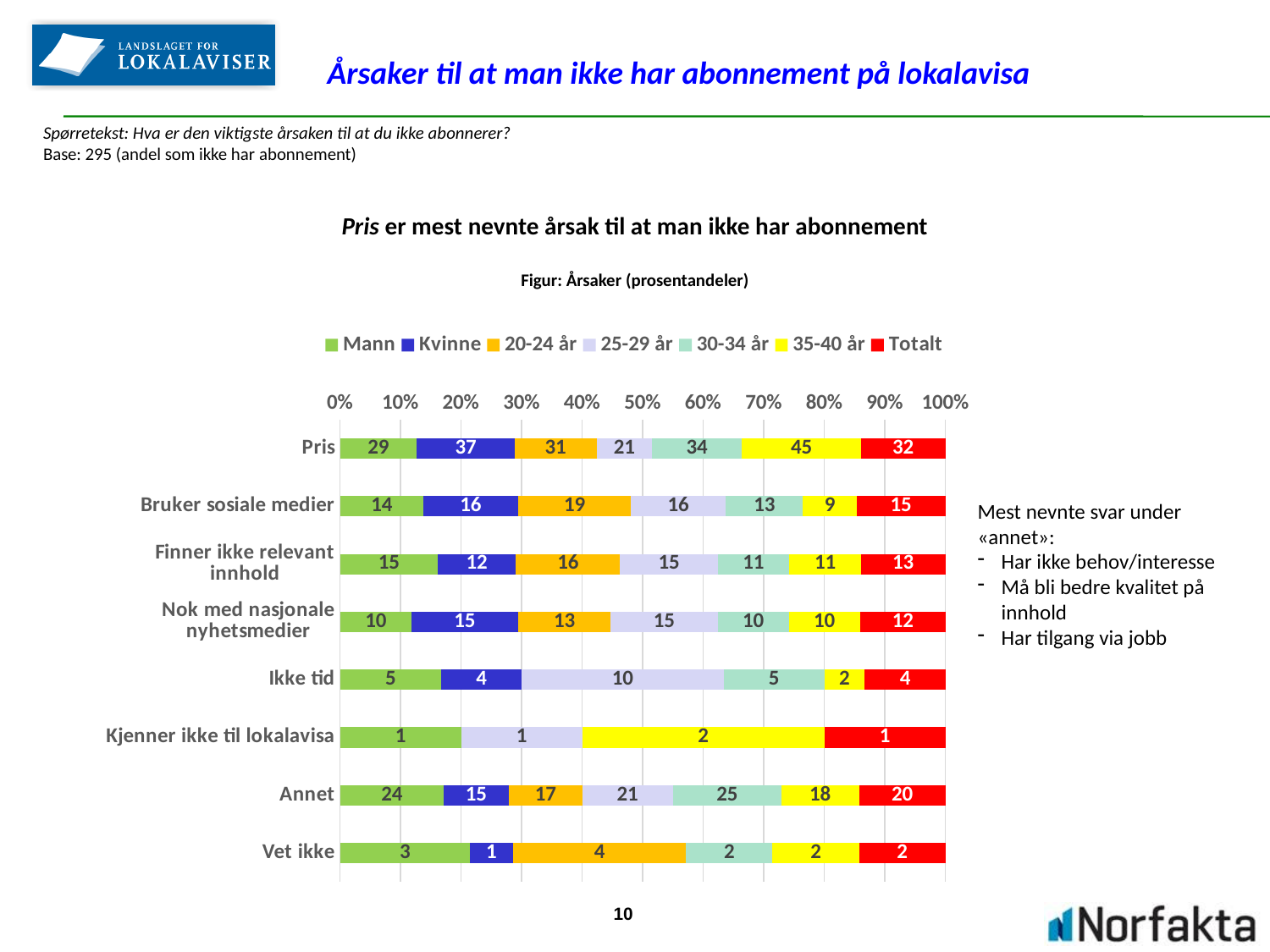
Which category has the highest Totalt value? Pris What kind of chart is shown on the slide? Stacked bar chart What is the difference between the Kvinne and Mann values for Pris? 8 What is the 35-40 år value for Pris? 45 What is the Kvinne value for Bruker sosiale medier? 16 How many categories are shown on the chart? 8 Which is larger for Annet: the Mann value or the Kvinne value? Mann How many series does the legend list? 7 What is the Totalt value for Pris? 32 What is the 30-34 år value for Annet? 25 Which colour represents the Totalt series in the chart? Red Which category has the lowest Totalt value? Kjenner ikke til lokalavisa